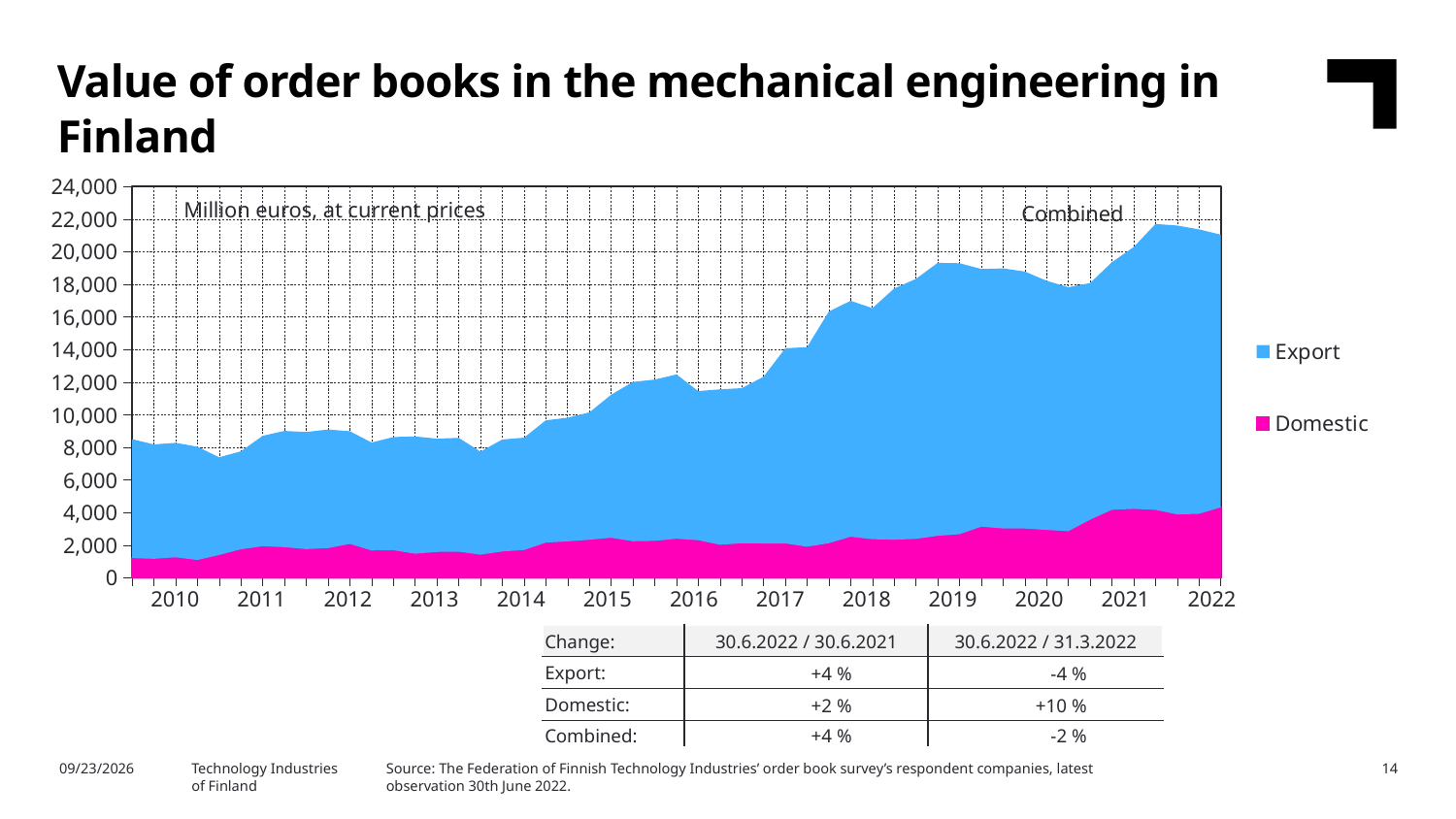
Is the combined value at 2010 greater or less than 10,000? less Which series is larger at 2022, Export or Domestic? Export How many year labels are shown on the x axis? 13 Is the combined value at 2022 greater or less than 20,000? greater What type of chart is shown on the slide? Area chart Is the combined value at 2019 greater or less than 18,000? greater What unit is stated for the values in the chart? Million euros, at current prices What are the two series named in the legend? Export and Domestic How many series does the legend list? 2 Does the combined value of order books generally rise or fall from 2010 to 2022? Rise